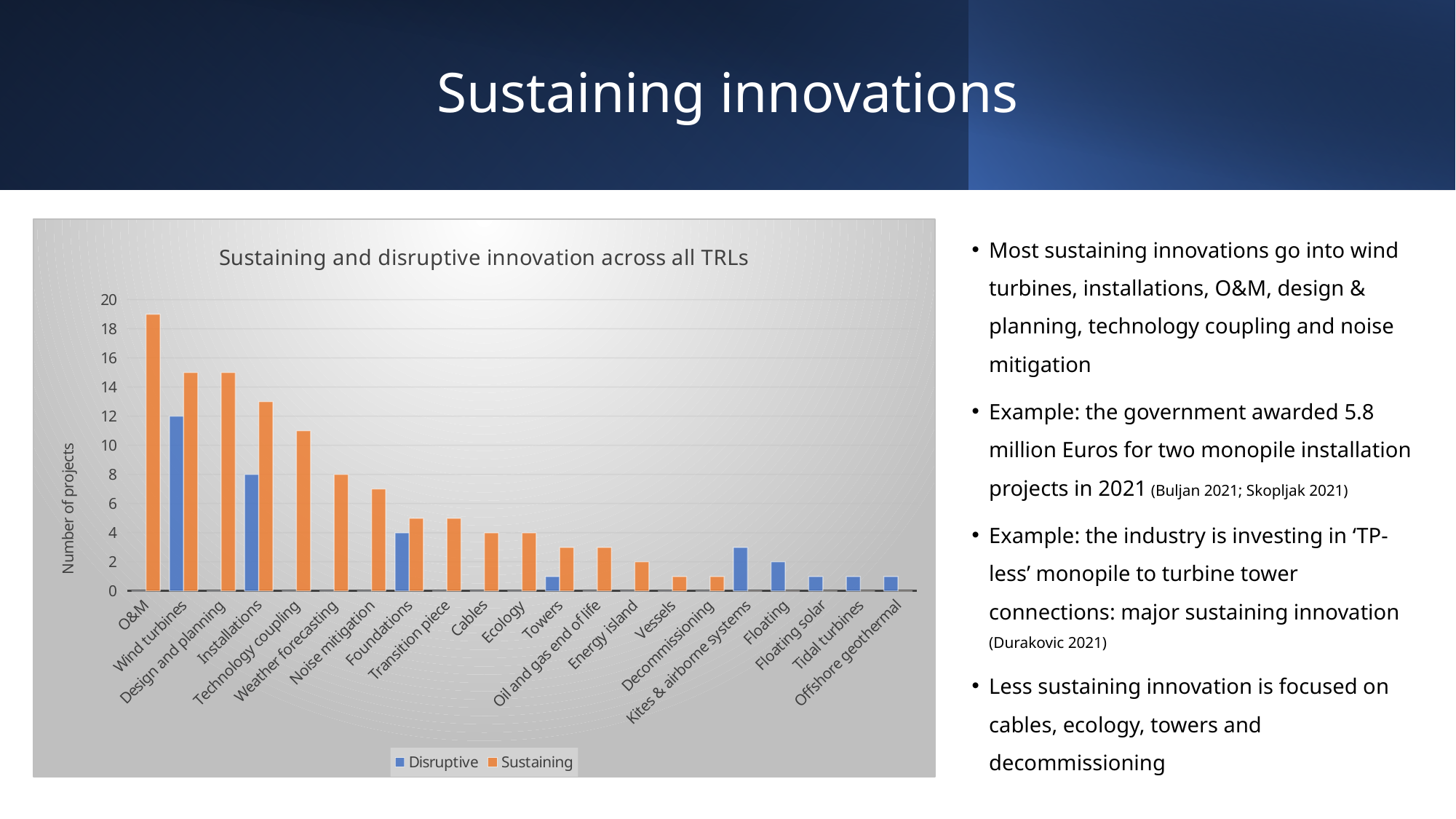
What is the Disruptive value for Wind turbines? 12 Is the Sustaining value for Technology coupling greater or less than 10? greater How many categories are shown on the x axis of the chart? 21 How many series does the chart legend list? 2 Which category has the highest Sustaining value? O&M What is the Sustaining value for Weather forecasting? 8 What is the title of the chart? Sustaining and disruptive innovation across all TRLs Do the Sustaining values generally rise or fall moving from left to right along the x axis? Fall What kind of chart is shown on the slide? Bar chart What is the Disruptive value for Installations? 8 For Wind turbines, which is larger, the Sustaining value or the Disruptive value? Sustaining Is the Sustaining value for O&M greater or less than 18? greater